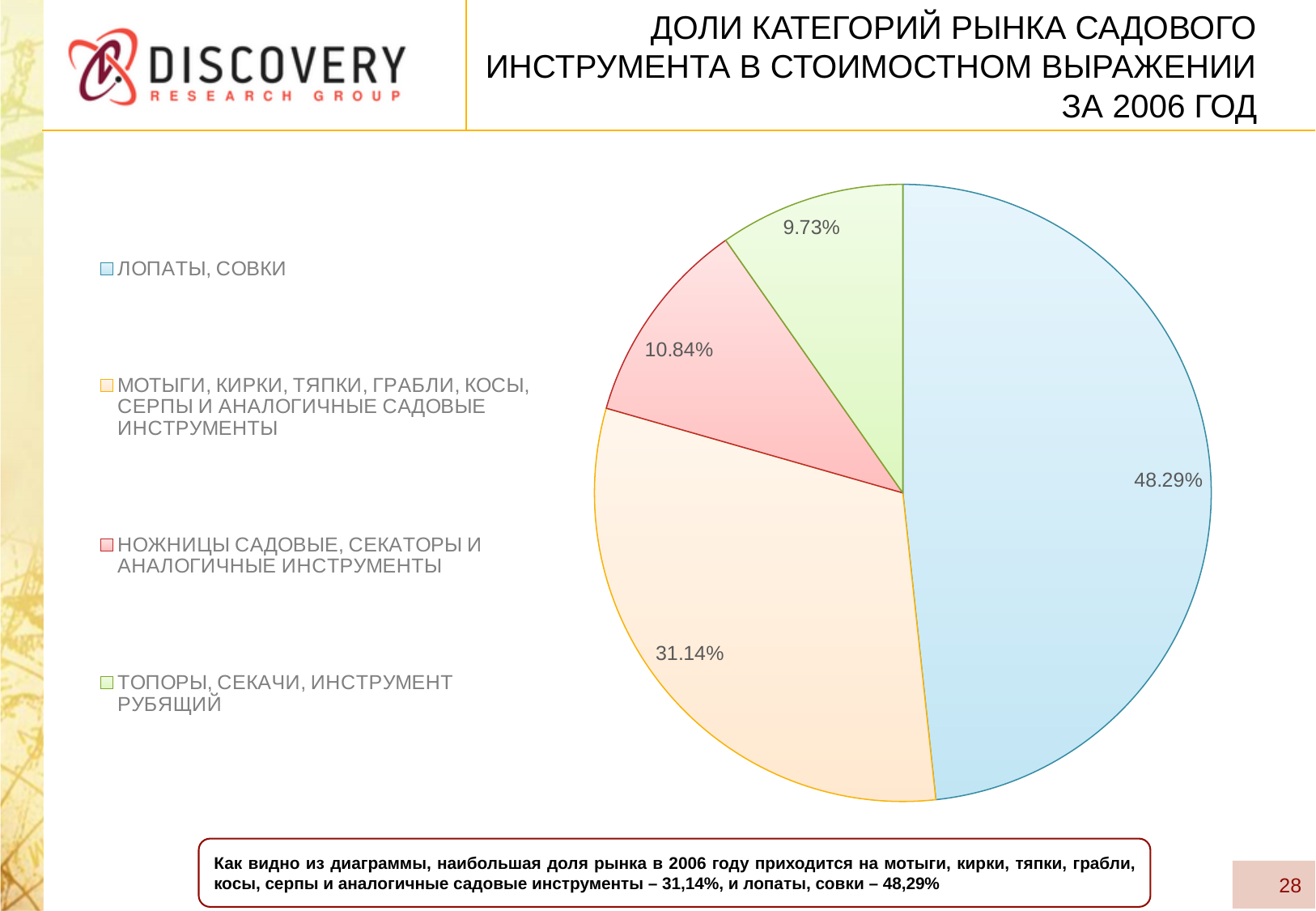
What share of the market does the category ЛОПАТЫ, СОВКИ hold? 48.29% Which category has the smallest share of the pie? ТОПОРЫ, СЕКАЧИ, ИНСТРУМЕНТ РУБЯЩИЙ Which has a larger share: НОЖНИЦЫ САДОВЫЕ, СЕКАТОРЫ И АНАЛОГИЧНЫЕ ИНСТРУМЕНТЫ or ТОПОРЫ, СЕКАЧИ, ИНСТРУМЕНТ РУБЯЩИЙ? НОЖНИЦЫ САДОВЫЕ, СЕКАТОРЫ И АНАЛОГИЧНЫЕ ИНСТРУМЕНТЫ How many categories are shown in the pie chart? 4 What year does the chart title say the data is for? 2006 Which category has the largest share of the pie? ЛОПАТЫ, СОВКИ What share is shown for НОЖНИЦЫ САДОВЫЕ, СЕКАТОРЫ И АНАЛОГИЧНЫЕ ИНСТРУМЕНТЫ? 10.84% What colour is the slice for ЛОПАТЫ, СОВКИ? blue What share is shown for ТОПОРЫ, СЕКАЧИ, ИНСТРУМЕНТ РУБЯЩИЙ? 9.73% What type of chart is shown on the slide? pie chart What share is shown for МОТЫГИ, КИРКИ, ТЯПКИ, ГРАБЛИ, КОСЫ, СЕРПЫ И АНАЛОГИЧНЫЕ САДОВЫЕ ИНСТРУМЕНТЫ? 31.14% What is the difference in percentage points between the share of ЛОПАТЫ, СОВКИ and the share of МОТЫГИ, КИРКИ, ТЯПКИ, ГРАБЛИ, КОСЫ, СЕРПЫ И АНАЛОГИЧНЫЕ САДОВЫЕ ИНСТРУМЕНТЫ? 17.15